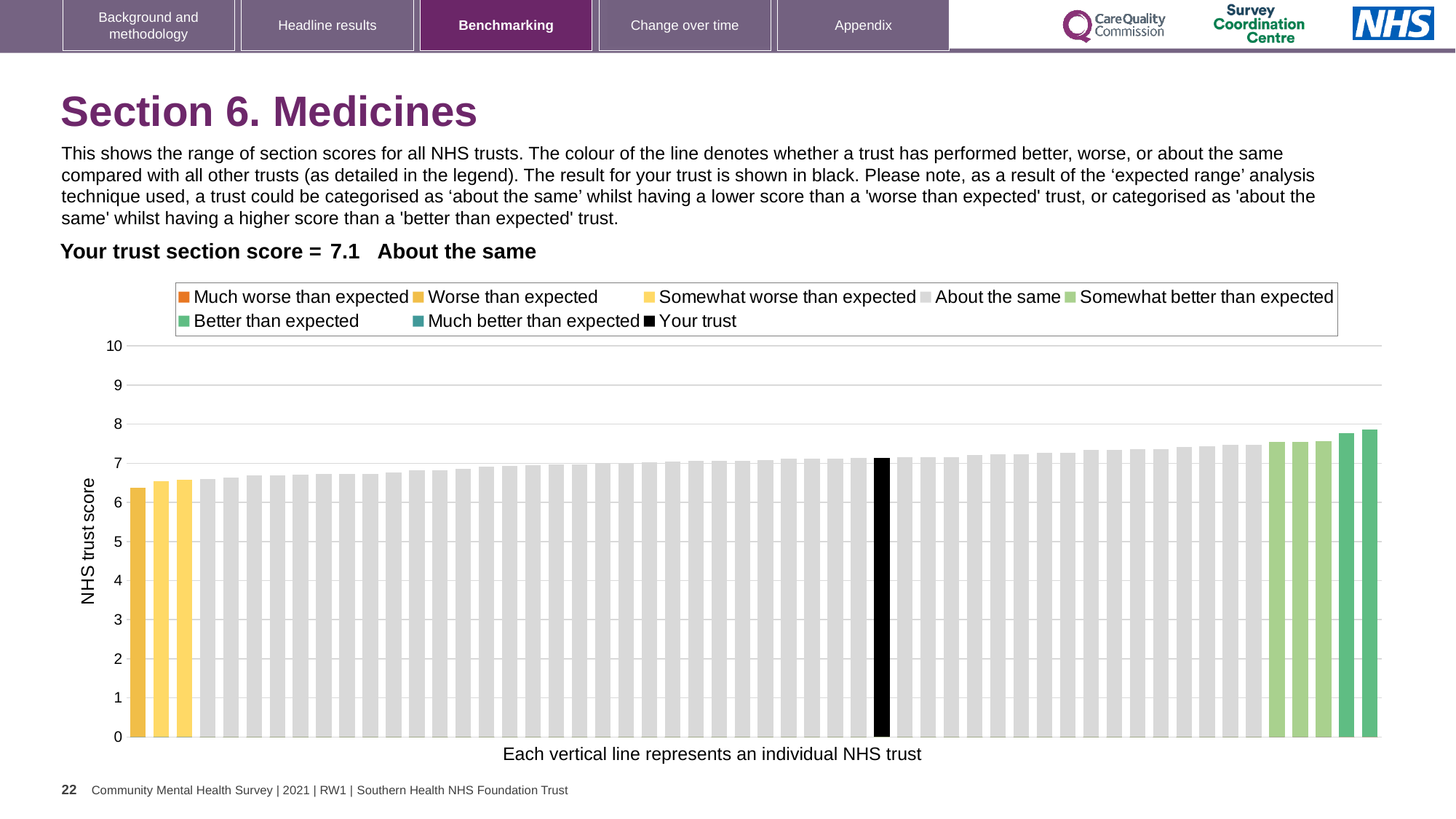
Is the value of the lowest bar in the chart greater or less than 7? less Is the value of the highest bar in the chart greater or less than 8? less How many green bars (better than expected categories) are shown at the right of the chart? 5 How many yellow bars (worse than expected categories) are shown at the left of the chart? 3 Do the bar values rise or fall from left to right along the x axis? rise Is the value for your trust greater or less than 5? greater What is the title of the vertical axis of the chart? NHS trust score What kind of chart is shown on the slide? bar chart How many entries does the chart legend list? 8 Which category is your trust placed in for the Medicines section? About the same What is the section score for your trust shown on the slide? 7.1 What colour is the bar representing your trust? black